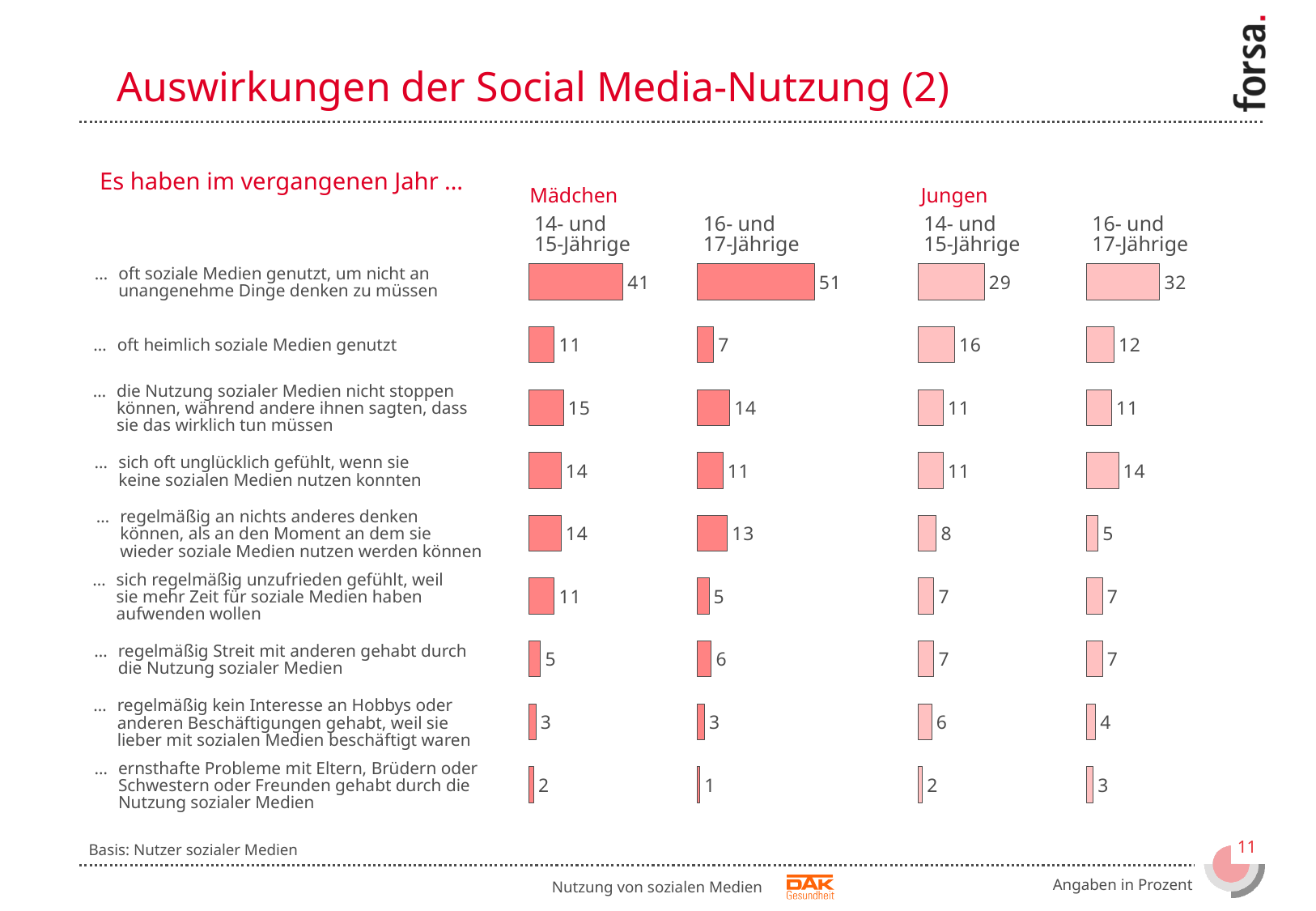
What is the difference between Mädchen 16- und 17-Jährige and Jungen 14- und 15-Jährige for "oft soziale Medien genutzt, um nicht an unangenehme Dinge denken zu müssen"? 22 What kind of chart is shown on the slide? Bar chart What is the value for Mädchen 14- und 15-Jährige for "oft soziale Medien genutzt, um nicht an unangenehme Dinge denken zu müssen"? 41 How many statements (categories) are shown in the chart? 9 What is the value for Jungen 16- und 17-Jährige for "oft heimlich soziale Medien genutzt"? 12 Which is larger for "oft heimlich soziale Medien genutzt": Mädchen 14- und 15-Jährige or Jungen 14- und 15-Jährige? Jungen 14- und 15-Jährige Which group has the highest value for "oft soziale Medien genutzt, um nicht an unangenehme Dinge denken zu müssen"? Mädchen 16- und 17-Jährige Which group has the lowest value for "ernsthafte Probleme mit Eltern, Brüdern oder Schwestern oder Freunden gehabt durch die Nutzung sozialer Medien"? Mädchen 16- und 17-Jährige What is the value for Jungen 14- und 15-Jährige for "regelmäßig an nichts anderes denken können, als an den Moment an dem sie wieder soziale Medien nutzen werden können"? 8 What is the difference between Mädchen 14- und 15-Jährige and Mädchen 16- und 17-Jährige for "sich regelmäßig unzufrieden gefühlt, weil sie mehr Zeit für soziale Medien haben aufwenden wollen"? 6 How many groups (columns of bars) are shown in the chart? 4 In what unit are the values on the slide given, according to the note at the bottom right? Prozent